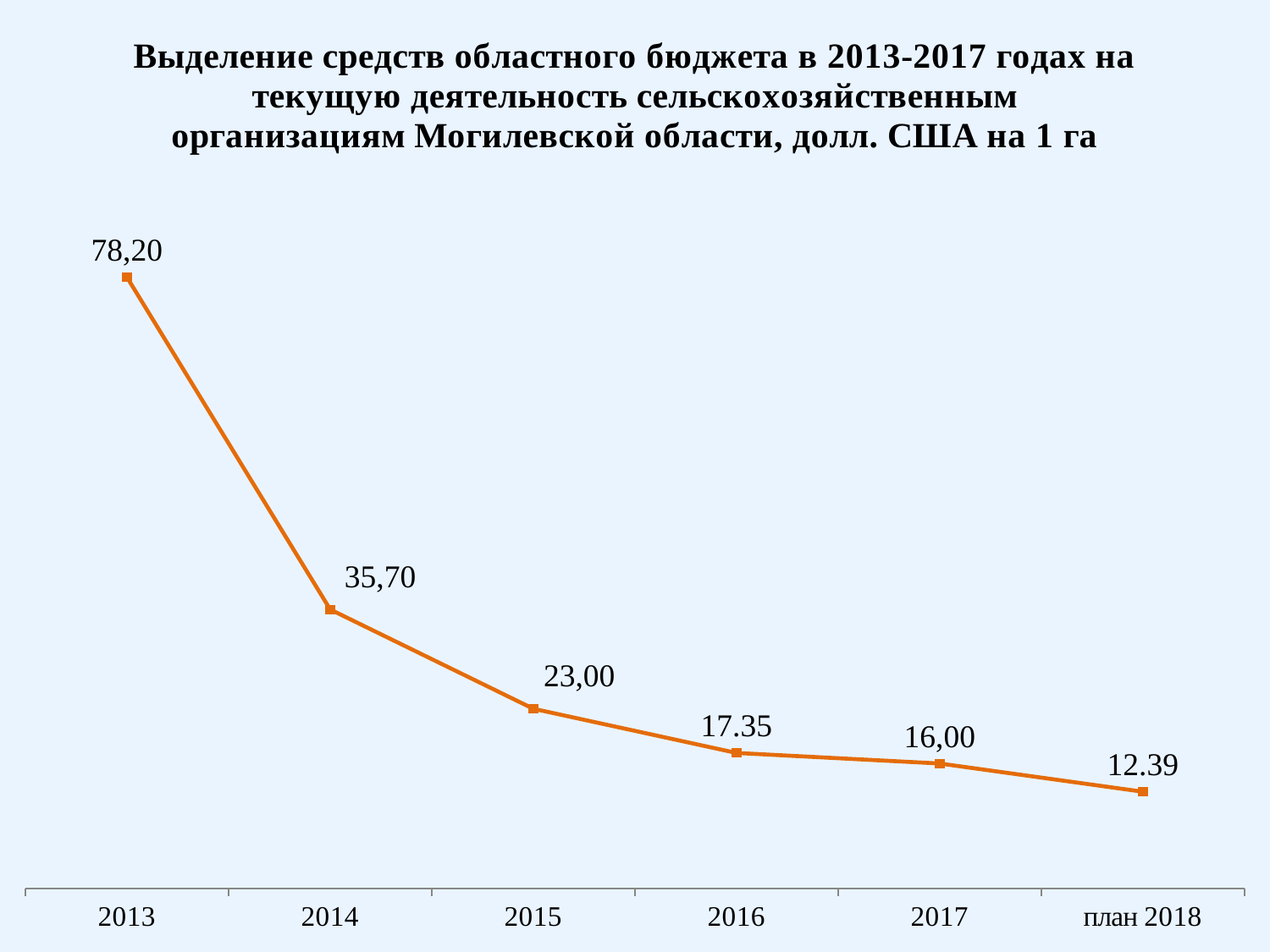
What is the value for 2013? 78,20 Do the values rise or fall from 2013 to план 2018? fall Which is larger, the value for 2016 or the value for 2017? 2016 What is the difference between the values for 2013 and 2014? 42,50 What is the difference between the values for 2015 and 2017? 7,00 Which year has the highest value? 2013 Which category has the lowest value? план 2018 What kind of chart is shown on the slide? line chart What is the value for план 2018? 12.39 What is the value for 2016? 17.35 How many data points are plotted on the chart? 6 What is the value for 2014? 35,70